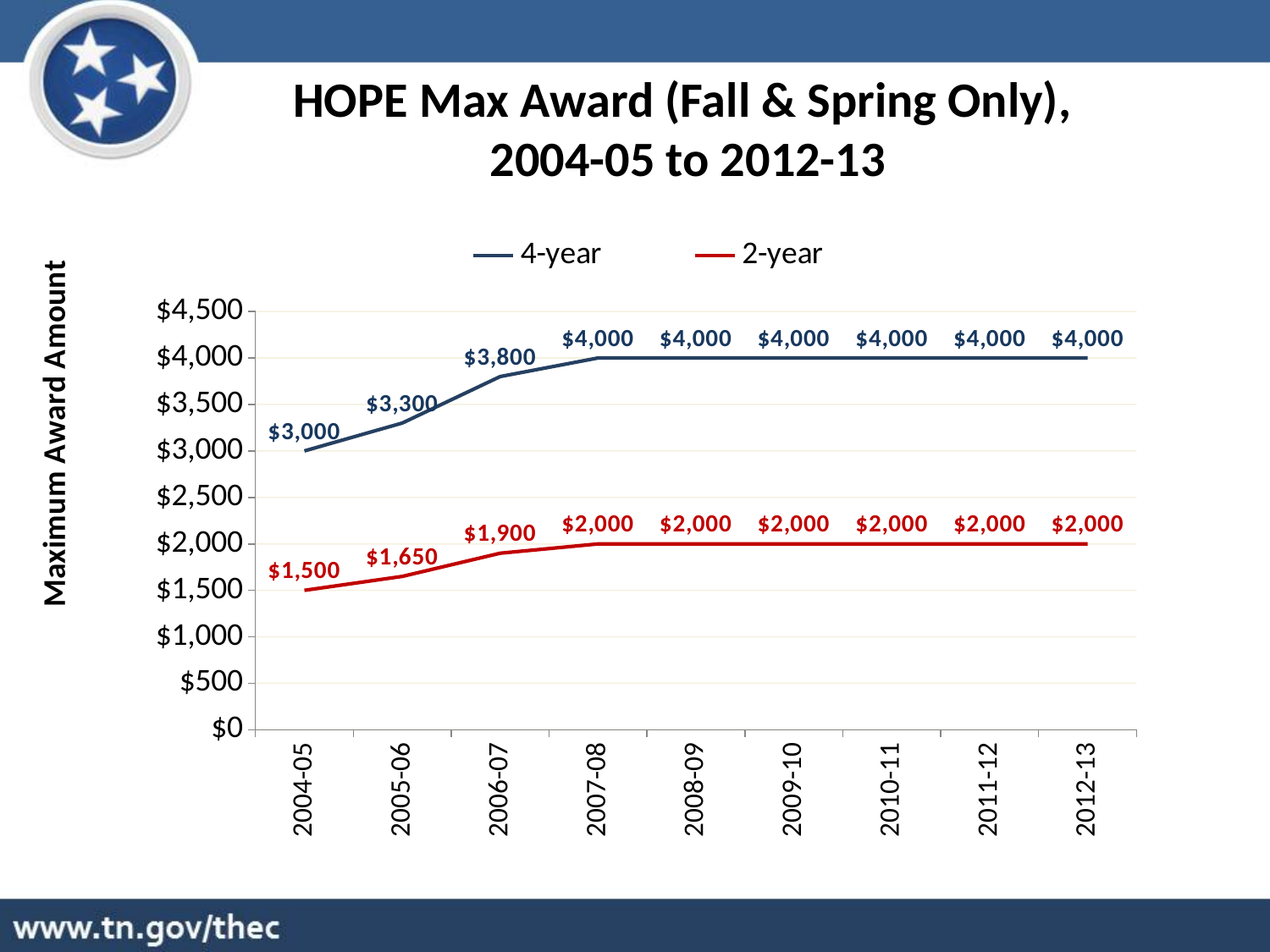
What is the 4-year maximum award amount for 2004-05? $3,000 Which is larger in 2006-07, the 4-year award or the 2-year award? 4-year How many series does the legend list? 2 What is the 2-year maximum award amount for 2012-13? $2,000 Does the 4-year maximum award amount rise or fall from 2004-05 to 2007-08? Rise By how much did the 4-year maximum award amount increase from 2004-05 to 2005-06? $300 What kind of chart is shown on the slide? Line chart What is the difference between the 4-year and 2-year maximum award amounts in 2007-08? $2,000 What is the 2-year maximum award amount for 2005-06? $1,650 In which year is the 2-year maximum award amount lowest? 2004-05 How many academic years are shown on the x axis? 9 What is the 4-year maximum award amount for 2006-07? $3,800